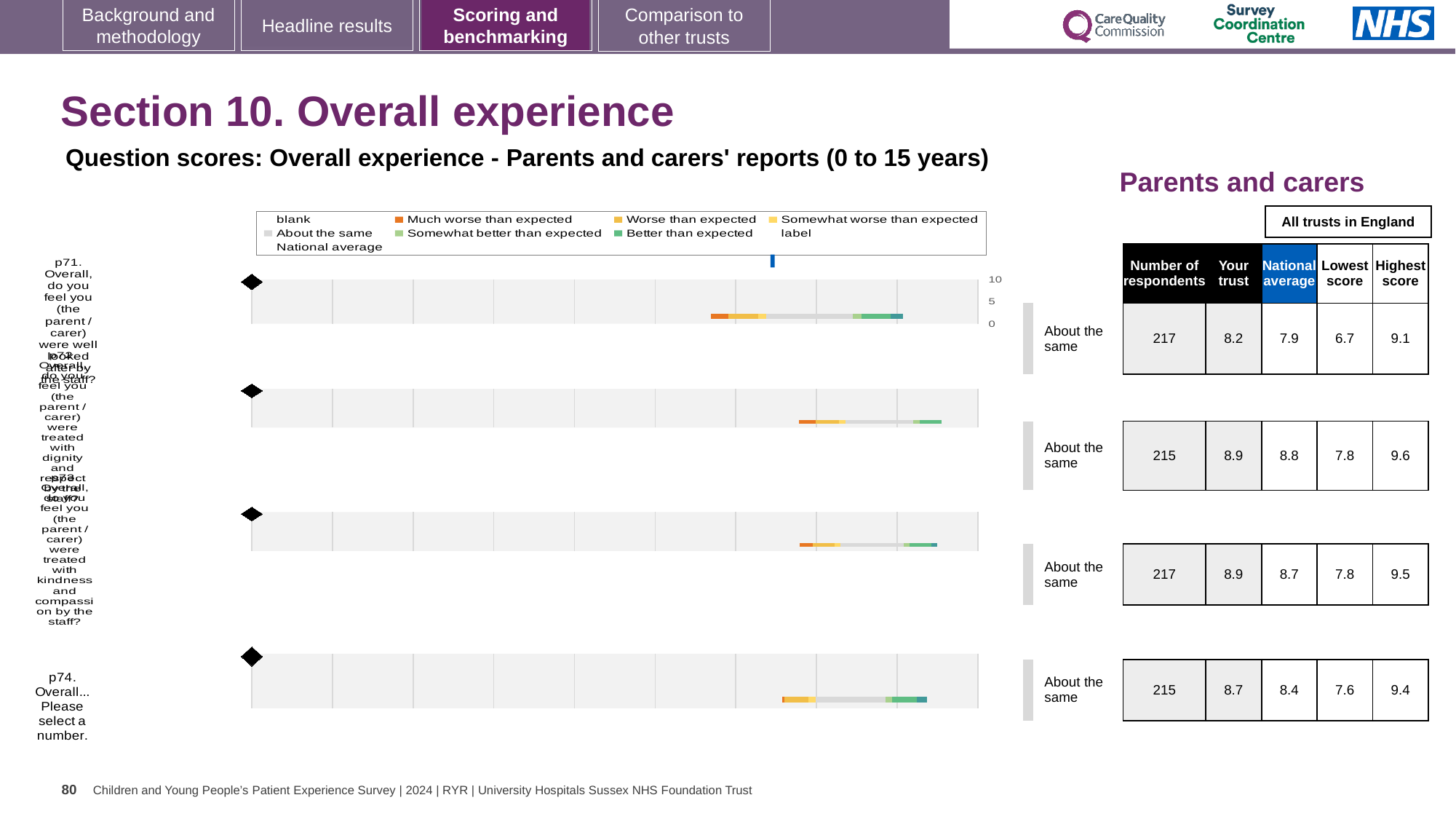
What is the national average score for p74 (Overall... Please select a number)? 8.4 Which question row has the highest 'Highest score' value in the table? p72 (second row), 9.6 What is the national average for the second question row (p72)? 8.8 What is the 'Your trust' score for p74 (Overall... Please select a number)? 8.7 What benchmark category is shown next to each of the four question rows? About the same How many respondents are shown for the first question row (p71)? 217 How many entries does the chart legend list? 9 For p74, what is the difference between the 'Your trust' score and the national average? 0.3 Which question row has the lowest 'Lowest score' value in the table? p71 (first row), 6.7 How many question rows (bars) are plotted in the chart? 4 For the first question row (p71), which is larger: the 'Your trust' score or the national average? Your trust (8.2) What kind of chart is used to show the question scores on this slide? bar chart